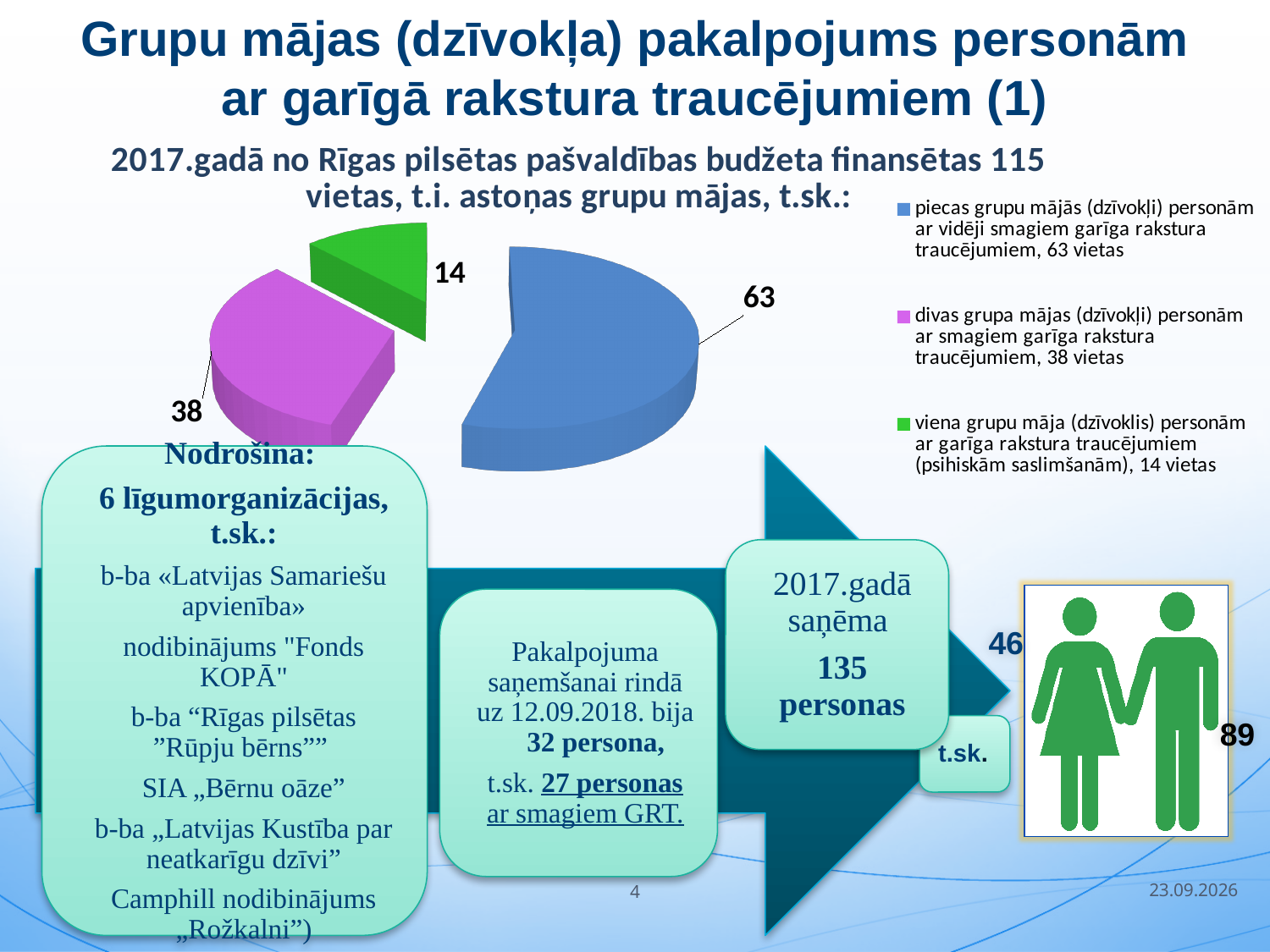
What is the difference between the blue slice (63) and the magenta slice (38) in the pie chart? 25 How many slices does the pie chart have? 3 What value is shown for the blue slice of the pie chart (piecas grupu mājās personām ar vidēji smagiem garīga rakstura traucējumiem)? 63 What kind of chart is shown on the slide? pie chart Which slice of the pie chart has the largest value? piecas grupu mājās (dzīvokļi) personām ar vidēji smagiem garīga rakstura traucējumiem, 63 What value is shown for the slice 'divas grupa mājas (dzīvokļi) personām ar smagiem garīga rakstura traucējumiem'? 38 Which colour in the pie chart represents the 14 vietas slice? green What is the difference between the magenta slice (38) and the green slice (14) in the pie chart? 24 Which is larger in the pie chart: the magenta slice or the green slice? the magenta slice (38) What value is shown for the green slice of the pie chart (viena grupu māja personām ar garīga rakstura traucējumiem (psihiskām saslimšanām))? 14 Which slice of the pie chart has the smallest value? viena grupu māja (dzīvoklis) personām ar garīga rakstura traucējumiem (psihiskām saslimšanām), 14 What is the total of all three slices in the pie chart? 115